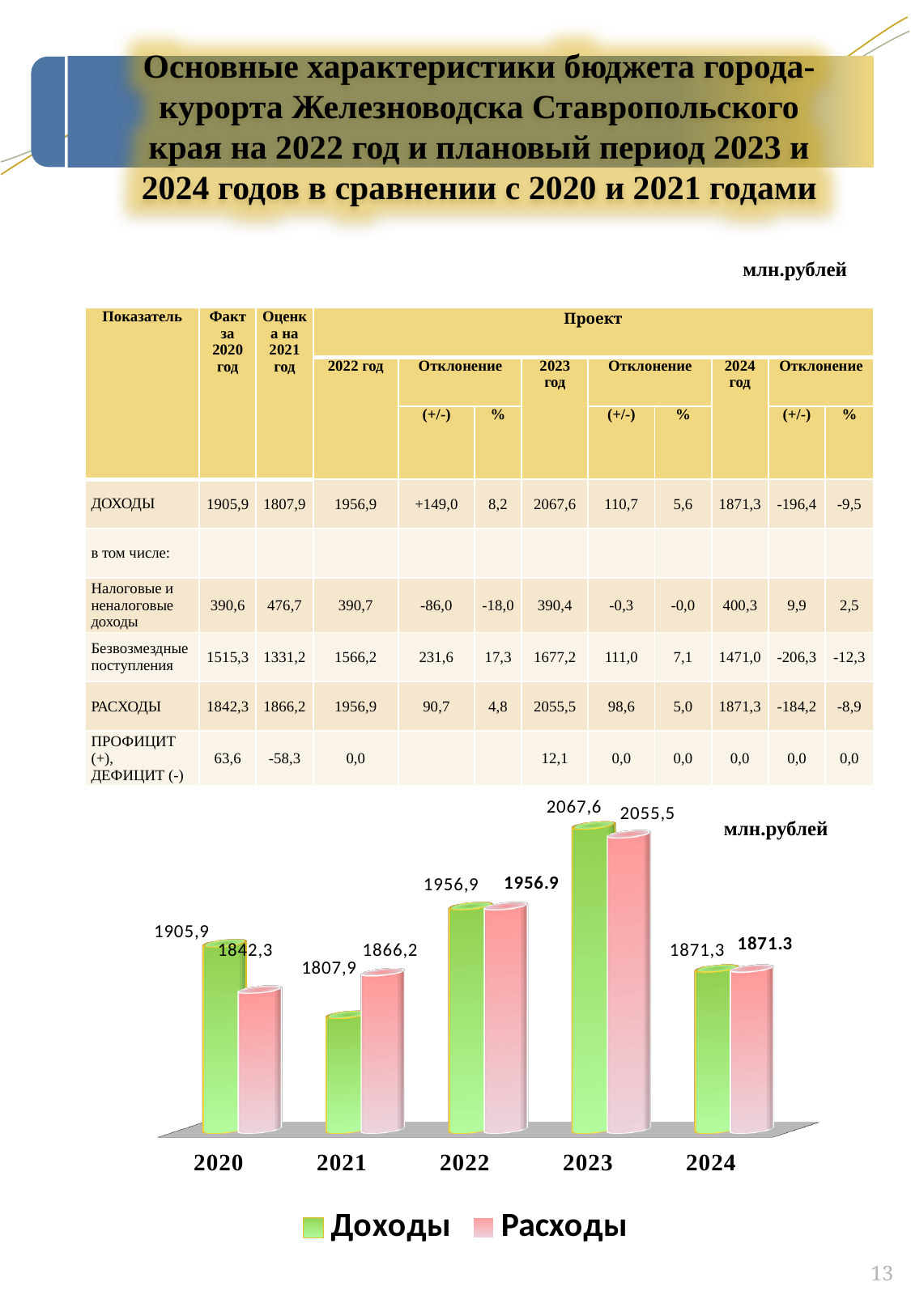
In which year is Доходы highest in the bar chart? 2023 What is the value of Доходы for 2023 in the bar chart? 2067,6 What is the value of Доходы for 2020 in the bar chart? 1905,9 How many years are shown on the x axis of the bar chart? 5 How many series does the legend of the bar chart list? 2 What is the value of Расходы for 2024 in the bar chart? 1871.3 What is the value of Расходы for 2021 in the bar chart? 1866,2 What type of chart is shown at the bottom of the slide? Bar chart In which year is Расходы lowest in the bar chart? 2020 In which year is Доходы lowest in the bar chart? 2021 What is the difference between Доходы and Расходы for 2020 in the bar chart? 63,6 In 2021, which is larger in the bar chart: Доходы or Расходы? Расходы